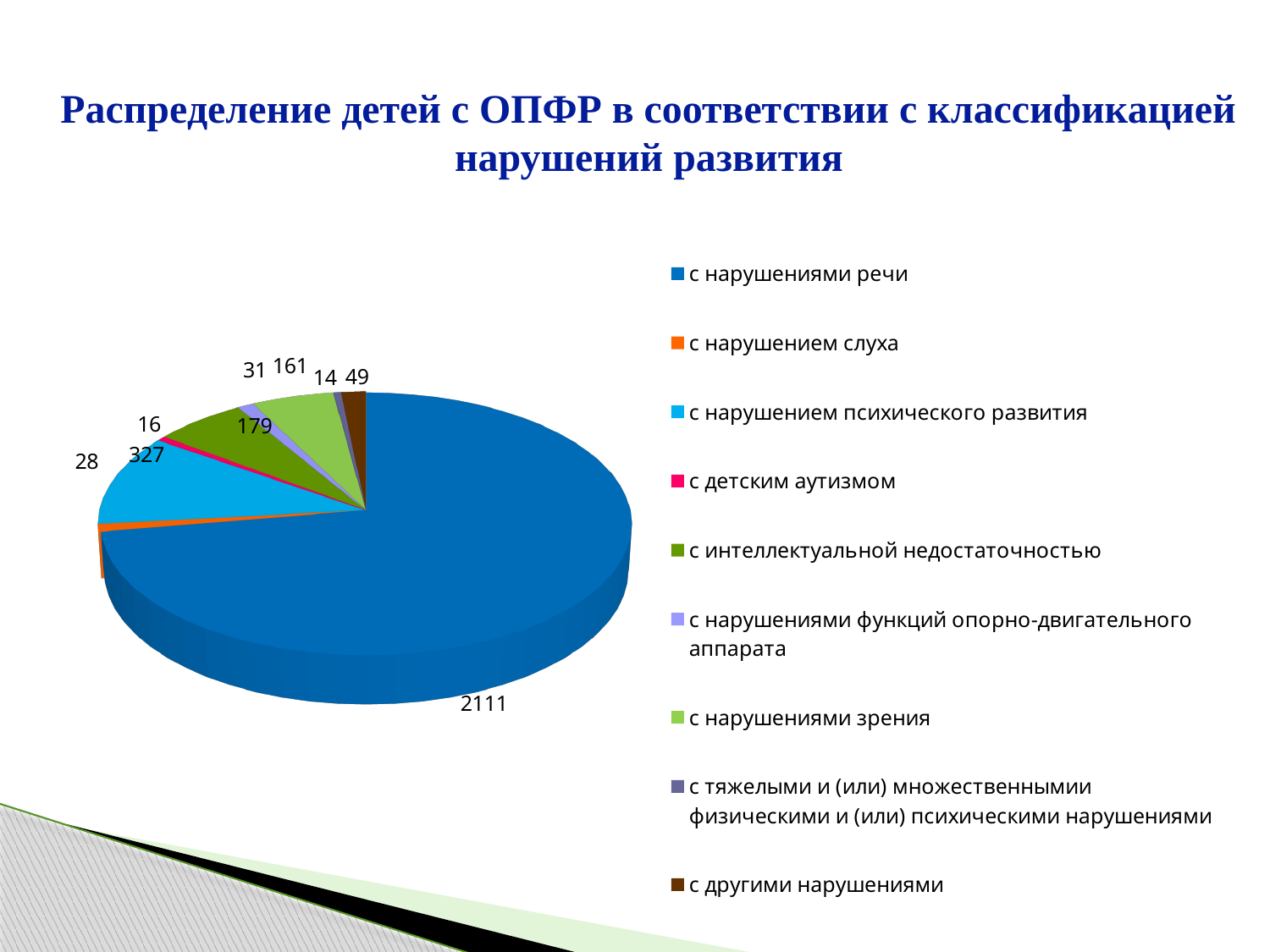
Which category has the smallest value in the pie chart? с тяжелыми и (или) множественнымии физическими и (или) психическими нарушениями What is the total of all values shown in the pie chart? 2916 What is the value for the category 'с нарушениями зрения'? 161 How many categories does the legend of the pie chart list? 9 What type of chart is shown on the slide? pie chart What is the value for the category 'с нарушением психического развития'? 327 Which category has the largest slice of the pie? с нарушениями речи What is the value for the category 'с детским аутизмом'? 16 What is the value for the category 'с интеллектуальной недостаточностью'? 179 What is the difference between the values for 'с нарушением психического развития' and 'с интеллектуальной недостаточностью'? 148 What is the value for the category 'с нарушениями речи'? 2111 Which is larger: the value for 'с нарушением слуха' or the value for 'с другими нарушениями'? с другими нарушениями